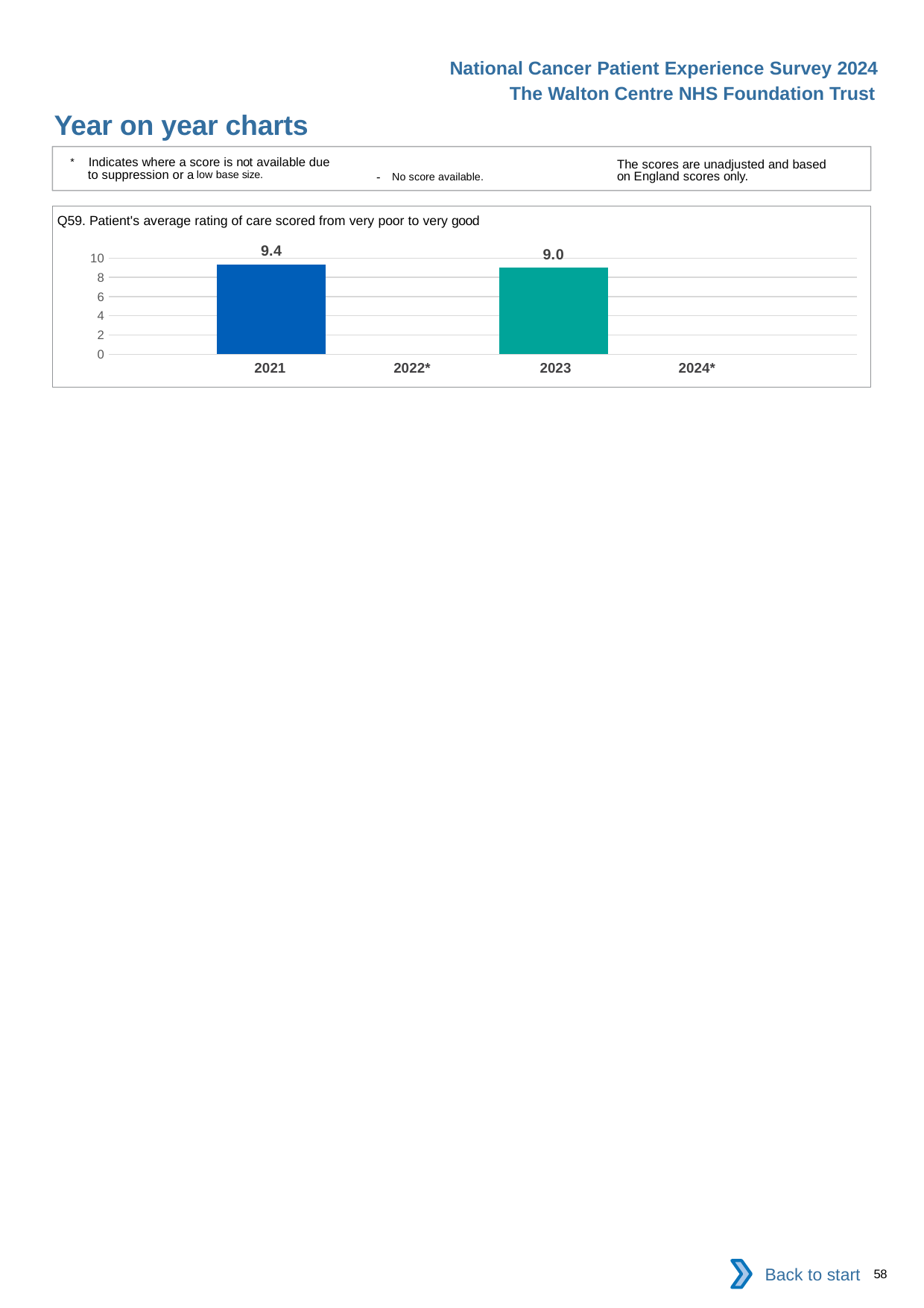
Which years in the Q59 chart have no bar plotted? 2022* and 2024* What is the value for 2021 in the Q59 chart? 9.4 What kind of chart is used for Q59? bar chart Which year has the highest value in the Q59 chart? 2021 Which is larger in the Q59 chart, the value for 2021 or the value for 2023? 2021 Is the value for 2023 in the Q59 chart greater or less than 8? greater What is the difference between the 2021 and 2023 values in the Q59 chart? 0.4 What is the title of the chart on the slide? Q59. Patient's average rating of care scored from very poor to very good What is the maximum value shown on the y axis of the Q59 chart? 10 How many year categories are shown on the x axis of the Q59 chart? 4 Do the plotted values in the Q59 chart rise or fall from 2021 to 2023? fall What is the value for 2023 in the Q59 chart? 9.0